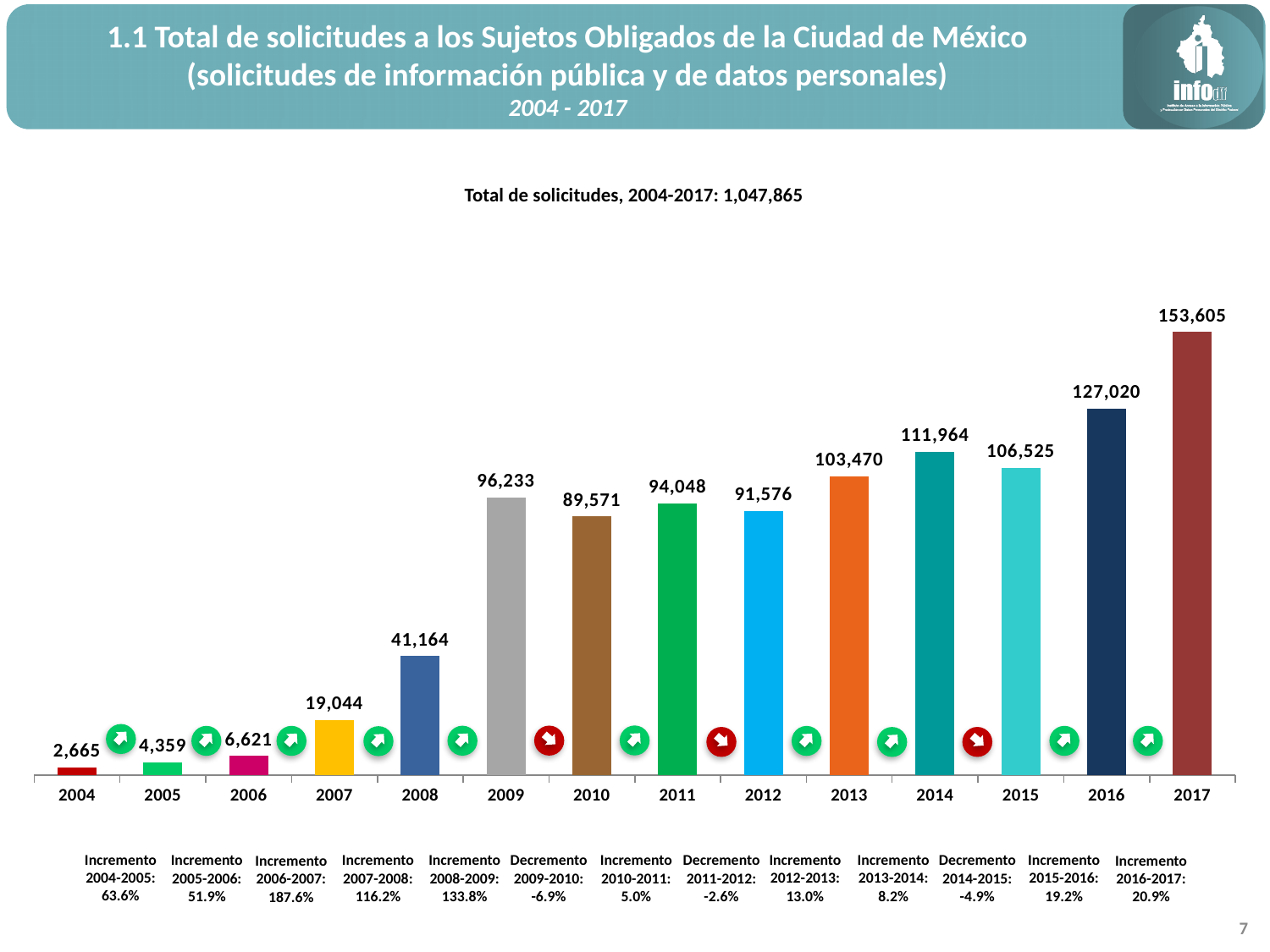
Which year has the lowest value? 2004 What is the value for 2017? 153,605 Do the values generally rise or fall from 2004 to 2017? rise What is the value for 2004? 2,665 Which is larger, the value for 2011 or the value for 2012? 2011 What total of solicitudes for 2004-2017 is stated above the chart? 1,047,865 What type of chart is shown on the slide? bar chart Which year has the highest value? 2017 What is the difference between the values for 2017 and 2016? 26,585 What is the difference between the values for 2009 and 2010? 6,662 What is the value for 2009? 96,233 How many years are shown on the x axis? 14